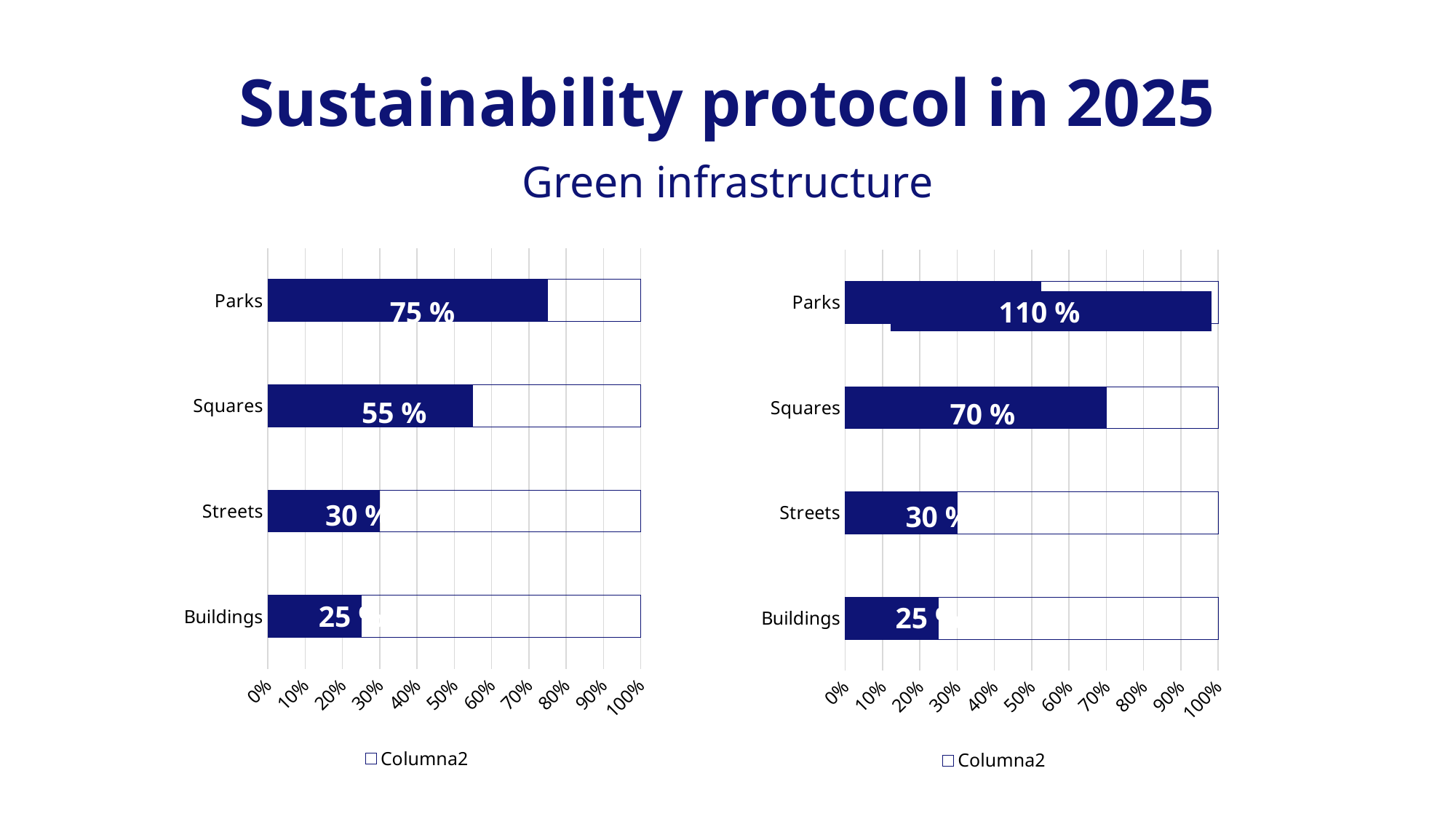
In the left chart, what is the difference between the values for Parks and Squares? 20 % In the right chart, what is the value for Parks? 110 % In the left chart, is the value for Buildings greater or less than 30%? less In the right chart, what is the difference between the values for Parks and Squares? 40 % In the right chart, what is the value for Squares? 70 % In the left chart, what is the value for Parks? 75 % What kind of chart is the right chart? bar chart In the left chart, what is the value for Squares? 55 % In the left chart, which category has the highest value? Parks In the right chart, which is larger, the value for Squares or the value for Streets? Squares In the right chart, which category has the lowest value? Buildings How many categories does the left chart show? 4